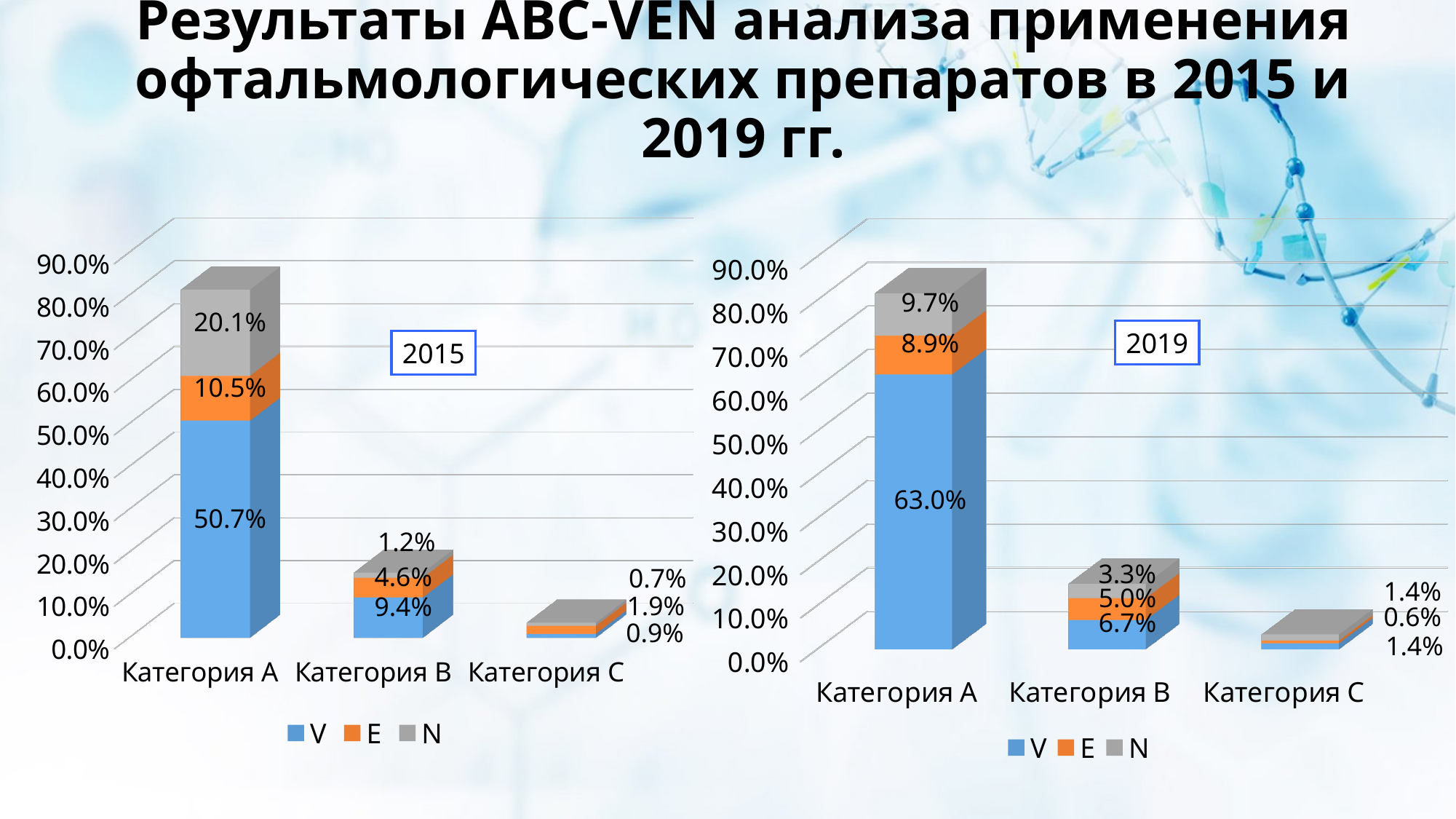
In the 2019 chart, which category has the lowest stacked bar? Категория C In the 2015 chart, what is the total of the stacked bar for Категория A? 81.3% How many series does the legend of the 2019 chart list? 3 In the 2019 chart, what is the value of series N for Категория A? 9.7% What is the difference between the V value for Категория A in the 2019 chart and the V value for Категория A in the 2015 chart? 12.3% What kind of chart is the 2015 chart? Stacked bar chart In the 2019 chart, what is the total of the stacked bar for Категория B? 15.0% In the 2015 chart, which is larger for Категория A: the E value or the N value? N In the 2015 chart, what is the value of series E for Категория B? 4.6% In the 2015 chart, which category has the highest stacked bar? Категория A In the 2019 chart, what is the value of series V for Категория C? 1.4% In the 2015 chart, what is the value of series V for Категория A? 50.7%